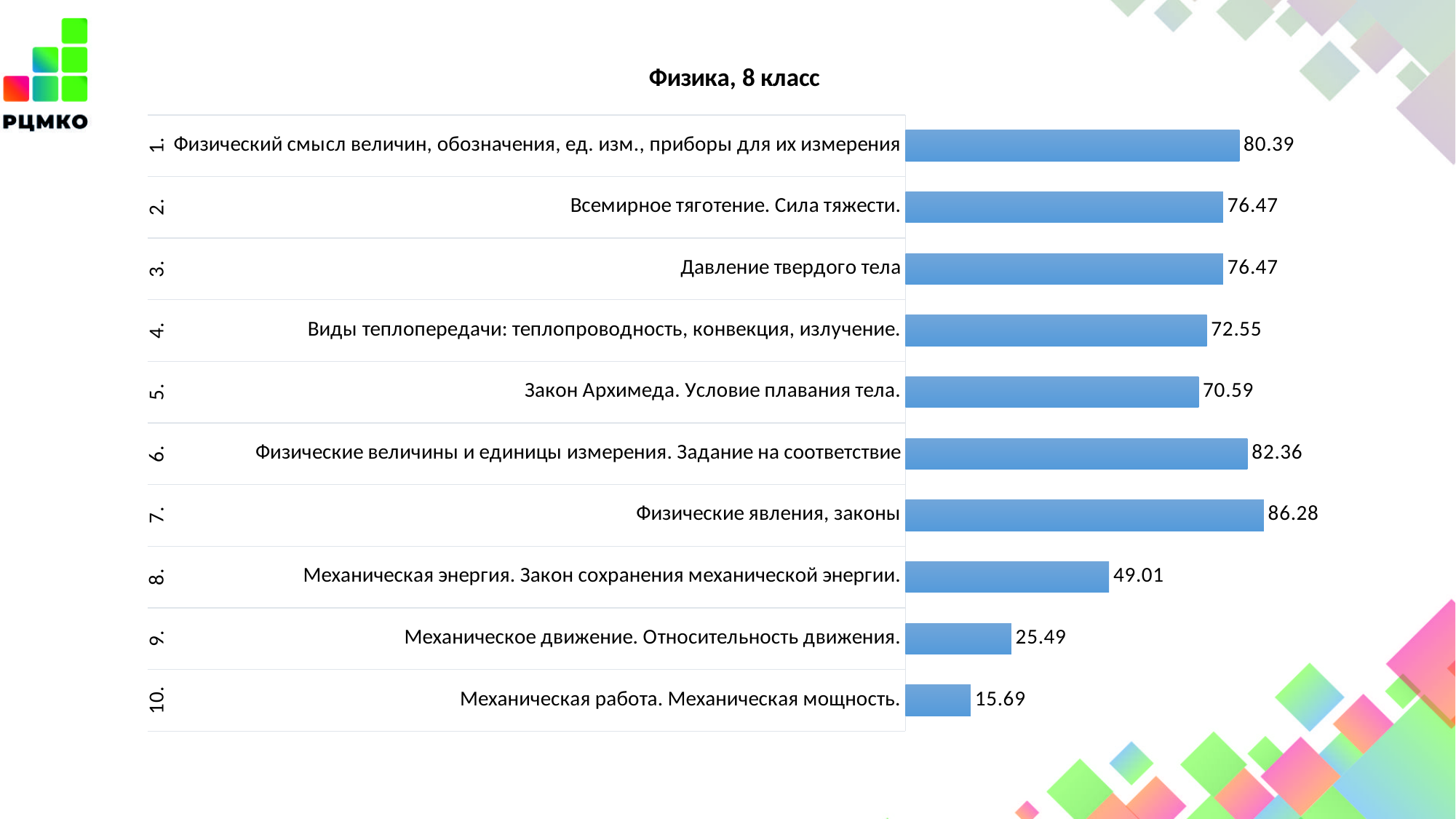
What is the value for "Механическая энергия. Закон сохранения механической энергии."? 49.01 Which category has the lowest value? Механическая работа. Механическая мощность. Which is larger: the value for "Физические величины и единицы измерения. Задание на соответствие" or the value for "Всемирное тяготение. Сила тяжести."? Физические величины и единицы измерения. Задание на соответствие How many categories are shown in the chart? 10 What is the title of the chart? Физика, 8 класс What kind of chart is shown on the slide? Bar chart What is the value for "Механическая работа. Механическая мощность."? 15.69 What is the difference between the values for "Физические явления, законы" and "Механическая работа. Механическая мощность."? 70.59 Which category has the highest value? Физические явления, законы What is the value for "Физические явления, законы"? 86.28 What is the difference between the values for "Физический смысл величин, обозначения, ед. изм., приборы для их измерения" and "Виды теплопередачи: теплопроводность, конвекция, излучение."? 7.84 What is the value for "Закон Архимеда. Условие плавания тела."? 70.59